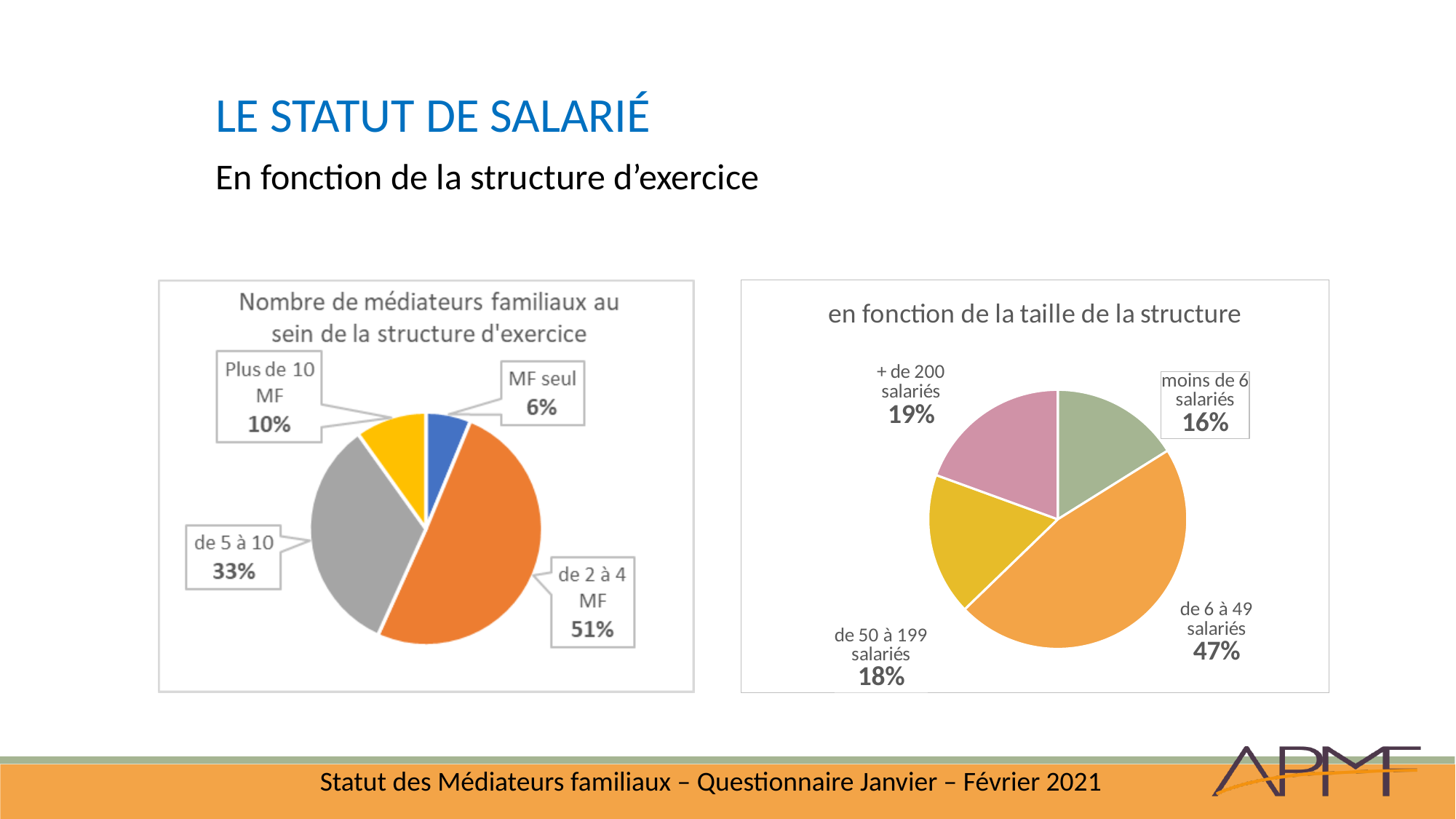
What type of chart is the right chart 'en fonction de la taille de la structure'? Pie chart In the left chart 'Nombre de médiateurs familiaux au sein de la structure d'exercice', what is the difference between 'de 5 à 10' and 'Plus de 10 MF'? 23% In the right chart 'en fonction de la taille de la structure', which is larger: '+ de 200 salariés' or 'moins de 6 salariés'? + de 200 salariés In the right chart 'en fonction de la taille de la structure', which category has the smallest slice? moins de 6 salariés In the right chart 'en fonction de la taille de la structure', what is the difference between 'de 6 à 49 salariés' and '+ de 200 salariés'? 28% In the left chart 'Nombre de médiateurs familiaux au sein de la structure d'exercice', what share is 'de 2 à 4 MF'? 51% In the left chart 'Nombre de médiateurs familiaux au sein de la structure d'exercice', what share is 'MF seul'? 6% In the right chart 'en fonction de la taille de la structure', what share is 'de 6 à 49 salariés'? 47% In the left chart 'Nombre de médiateurs familiaux au sein de la structure d'exercice', how many slices does the pie have? 4 In the left chart 'Nombre de médiateurs familiaux au sein de la structure d'exercice', which category has the smallest slice? MF seul In the left chart 'Nombre de médiateurs familiaux au sein de la structure d'exercice', which category has the largest slice? de 2 à 4 MF